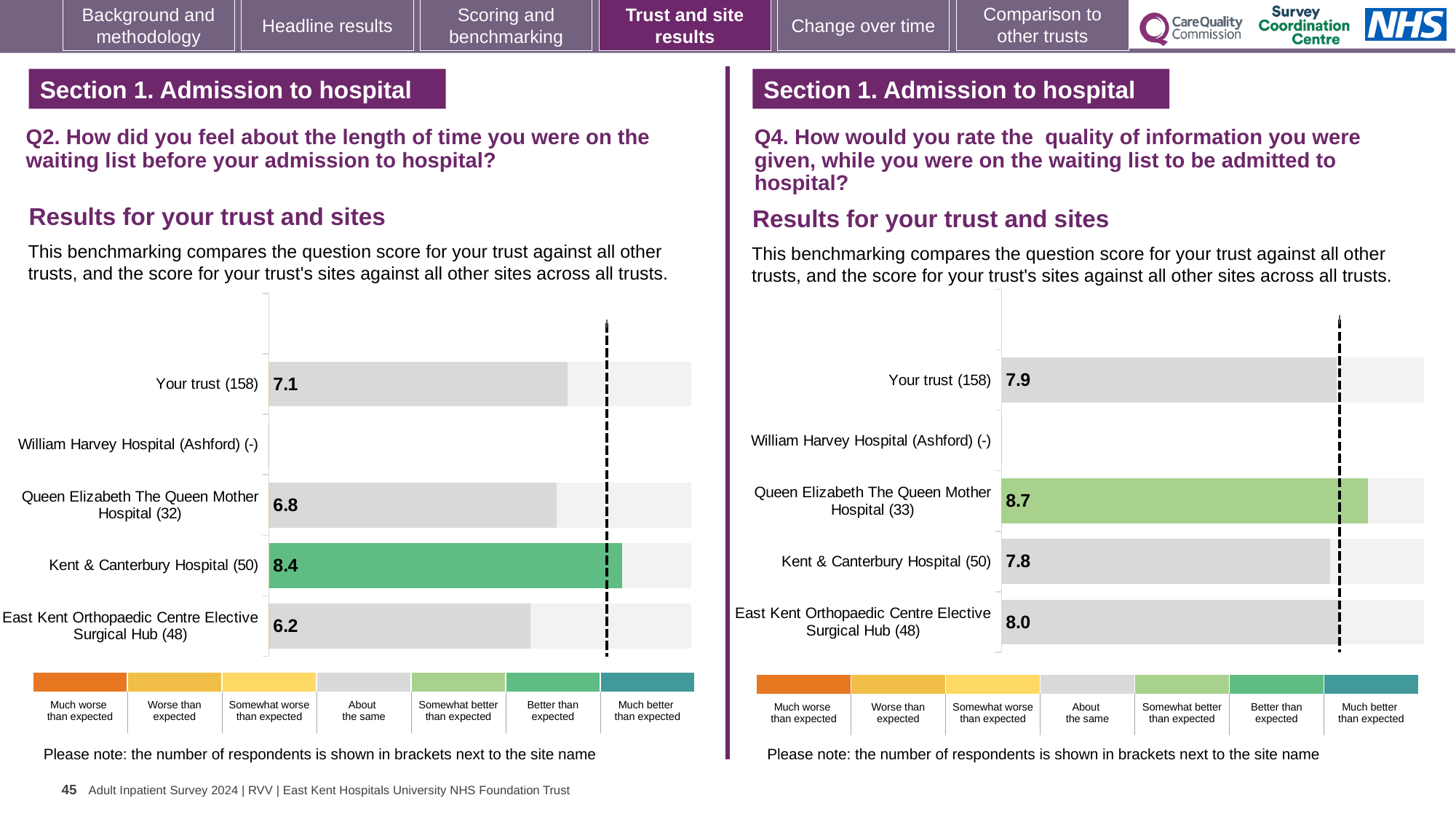
On the Q4 chart (right), how many categories are listed on the vertical axis? 5 On the Q2 chart (left), what is the score for Kent & Canterbury Hospital (50)? 8.4 On the Q2 chart (left), which is higher: the score for Your trust (158) or for East Kent Orthopaedic Centre Elective Surgical Hub (48)? Your trust (158) What kind of chart is used on the Q2 chart (left)? Bar chart On the Q2 chart (left), what is the score for Your trust (158)? 7.1 On the Q2 chart (left), which site's bar is coloured green? Kent & Canterbury Hospital (50) On the Q2 chart (left), what is the difference between the scores for Kent & Canterbury Hospital (50) and Queen Elizabeth The Queen Mother Hospital (32)? 1.6 On the Q4 chart (right), which site has the highest score? Queen Elizabeth The Queen Mother Hospital (33) On the Q2 chart (left), which site has the lowest score? East Kent Orthopaedic Centre Elective Surgical Hub (48) On the Q4 chart (right), what is the score for East Kent Orthopaedic Centre Elective Surgical Hub (48)? 8.0 On the Q4 chart (right), what is the score for Queen Elizabeth The Queen Mother Hospital (33)? 8.7 On the Q4 chart (right), what is the difference between the scores for Your trust (158) and Kent & Canterbury Hospital (50)? 0.1